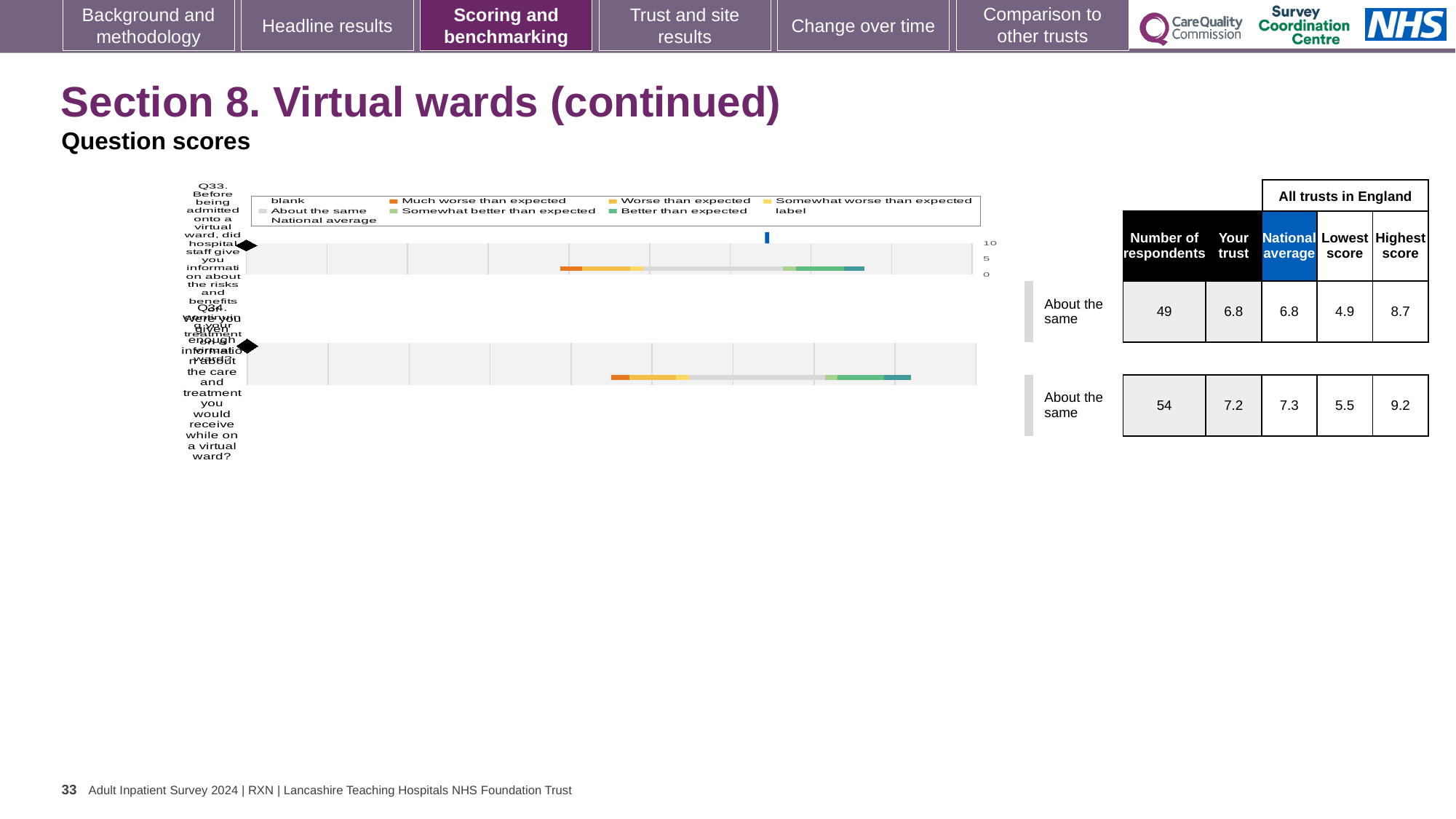
How many more respondents answered Q34 than Q33? 5 Which is larger for Q34: the 'Your trust' score or the national average? National average What is the 'Your trust' score for Q34 in the table next to the chart? 7.2 How many questions (bars) are plotted in the chart? 2 How many respondents answered Q33 according to the table? 49 What is the 'Your trust' score for Q33 in the table next to the chart? 6.8 What is the highest score for Q34 in the table? 9.2 What kind of chart is shown on the slide? Bar chart Which colour does the legend use for 'Much worse than expected'? Orange What is the national average for Q34 in the table next to the chart? 7.3 What benchmark category is shown for both Q33 and Q34? About the same What is the difference between the highest score and the lowest score for Q33 in the table? 3.8